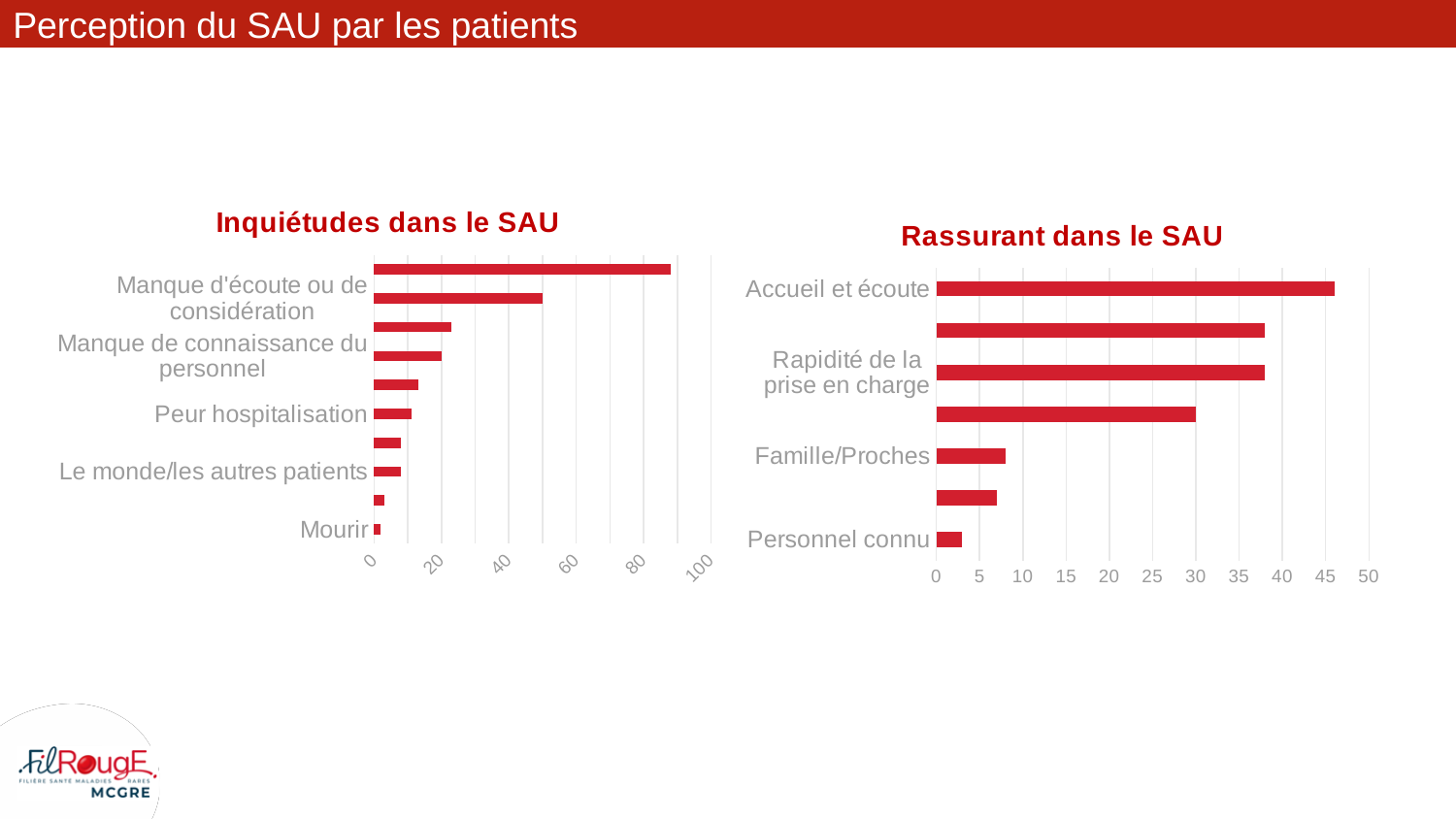
In the "Rassurant dans le SAU" chart, is the value for Famille/Proches greater or less than 5? greater In the "Rassurant dans le SAU" chart, which is larger: Accueil et écoute or Famille/Proches? Accueil et écoute What kind of chart is the "Rassurant dans le SAU" chart? bar chart In the "Inquiétudes dans le SAU" chart, is the value for Peur hospitalisation greater or less than 20? less In the "Inquiétudes dans le SAU" chart, is the value for Manque d'écoute ou de considération greater or less than 40? greater In the "Rassurant dans le SAU" chart, which labelled category has the lowest value? Personnel connu In the "Inquiétudes dans le SAU" chart, which labelled category has the lowest value? Mourir What kind of chart is the "Inquiétudes dans le SAU" chart? bar chart How many bars are plotted in the "Rassurant dans le SAU" chart? 7